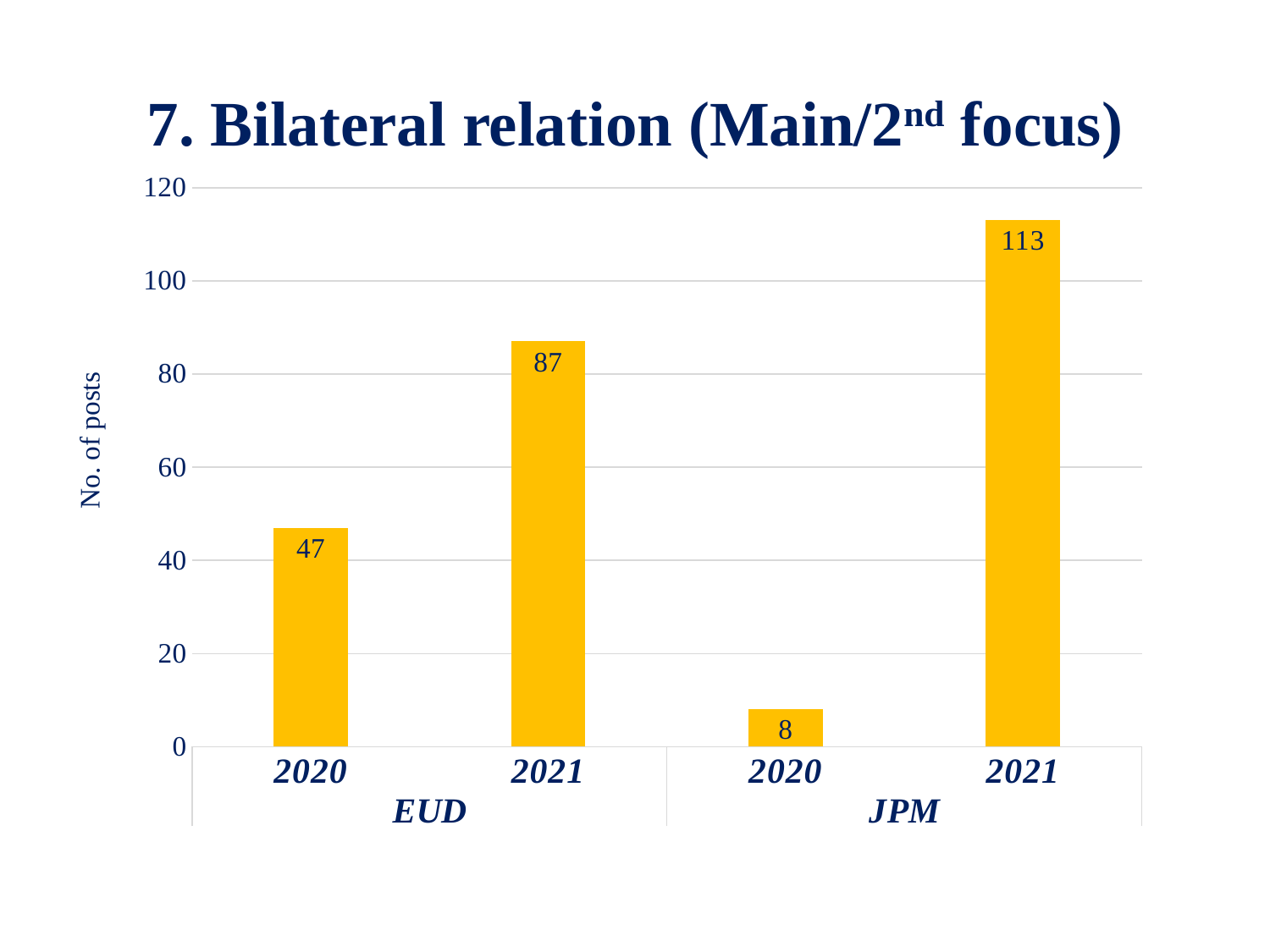
How many bars are plotted in the chart? 4 What is the difference in posts between EUD 2021 and EUD 2020? 40 What is the difference in posts between JPM 2021 and JPM 2020? 105 What is the number of posts for JPM in 2021? 113 What is the number of posts for EUD in 2020? 47 What is the label of the vertical axis? No. of posts What kind of chart is shown on the slide? Bar chart Which bar has the highest number of posts? JPM 2021 What is the number of posts for JPM in 2020? 8 Which bar has the lowest number of posts? JPM 2020 What is the number of posts for EUD in 2021? 87 Which is larger, the number of posts for EUD in 2021 or for JPM in 2021? JPM in 2021